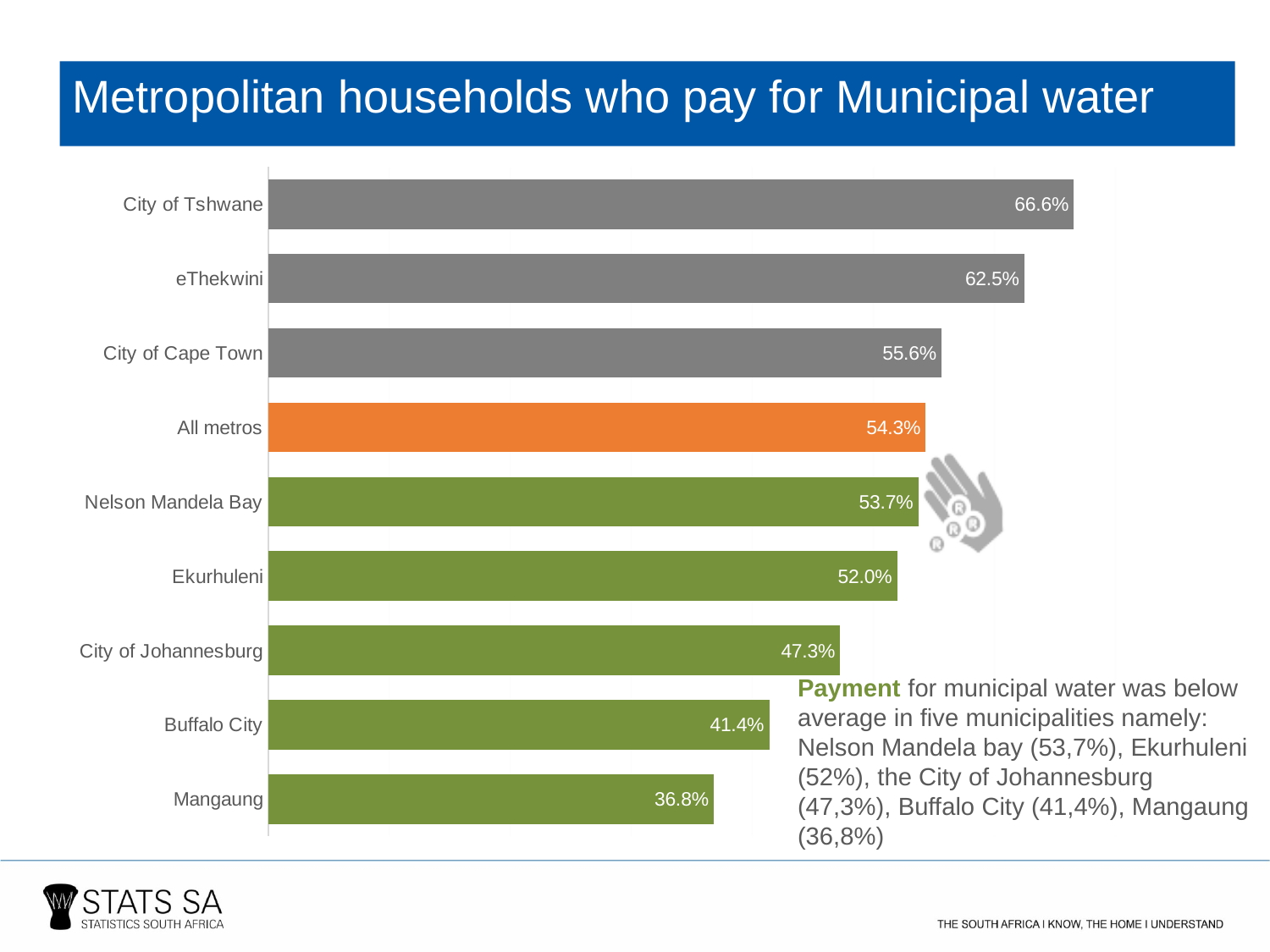
Which metro has the highest percentage of households paying for municipal water? City of Tshwane How many bars are shown in the chart? 9 What is the value shown for Ekurhuleni? 52.0% What is the difference in percentage points between the City of Tshwane and eThekwini? 4.1 Which metro has the lowest percentage of households paying for municipal water? Mangaung Which bar is coloured orange? All metros Which has a higher value, City of Cape Town or City of Johannesburg? City of Cape Town What is the difference in percentage points between Buffalo City and Mangaung? 4.6 What is the value shown for Mangaung? 36.8% What is the value shown for All metros? 54.3% What type of chart is shown on the slide? Bar chart What percentage of households in the City of Tshwane pay for municipal water? 66.6%